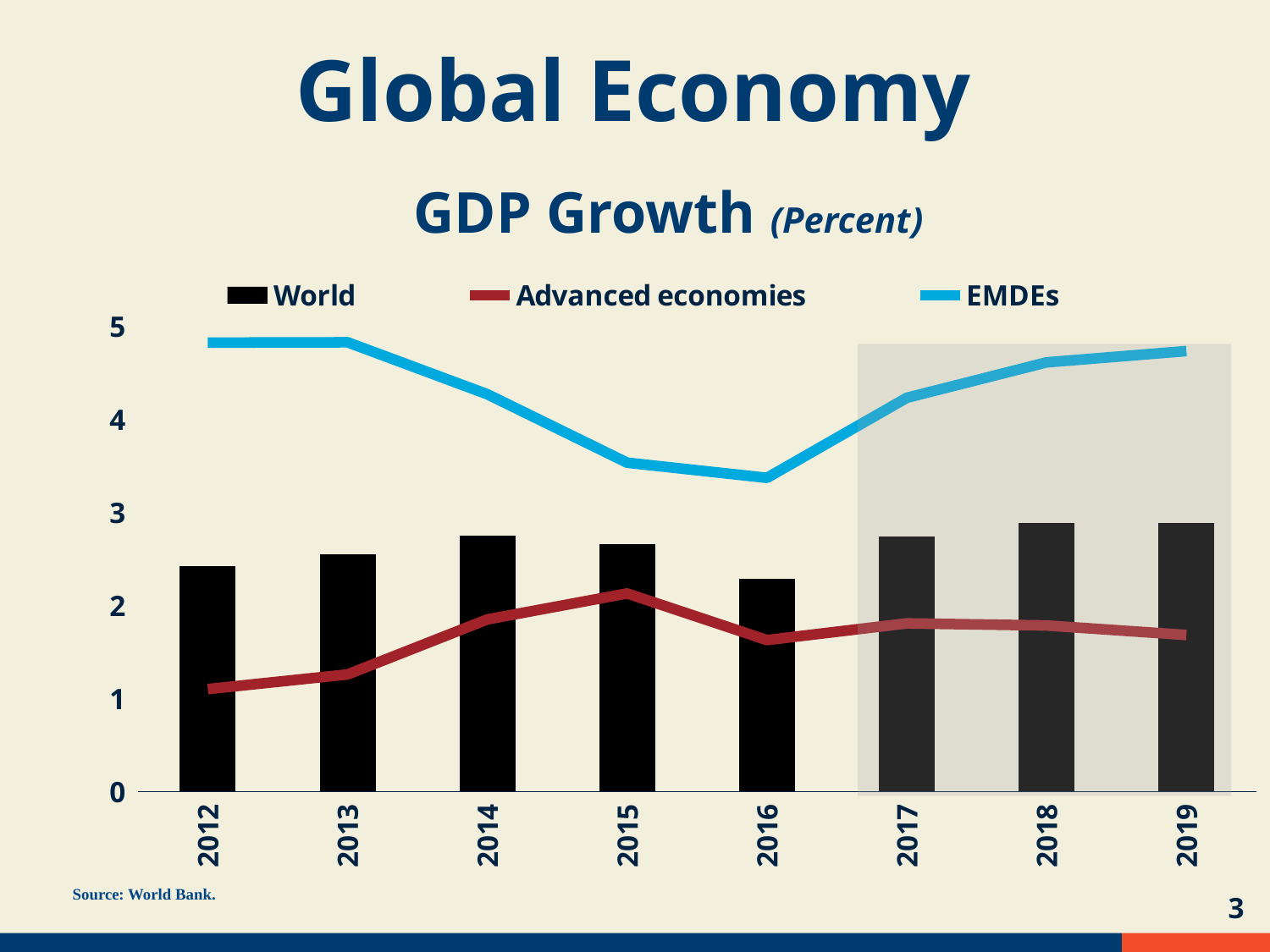
In which year is the Advanced economies line highest? 2015 In which year is the Advanced economies line lowest? 2012 How many years are shown on the x axis? 8 What kind of chart is shown on the slide? A combined bar and line chart Does the EMDEs line rise or fall from 2013 to 2016? fall Which series is plotted as bars? World In which year is the World bar lowest? 2016 How many series does the legend list? 3 Is the Advanced economies value for 2012 greater or less than 2? less Is the World value for 2016 greater or less than 3? less Is the EMDEs value for 2016 greater or less than 4? less